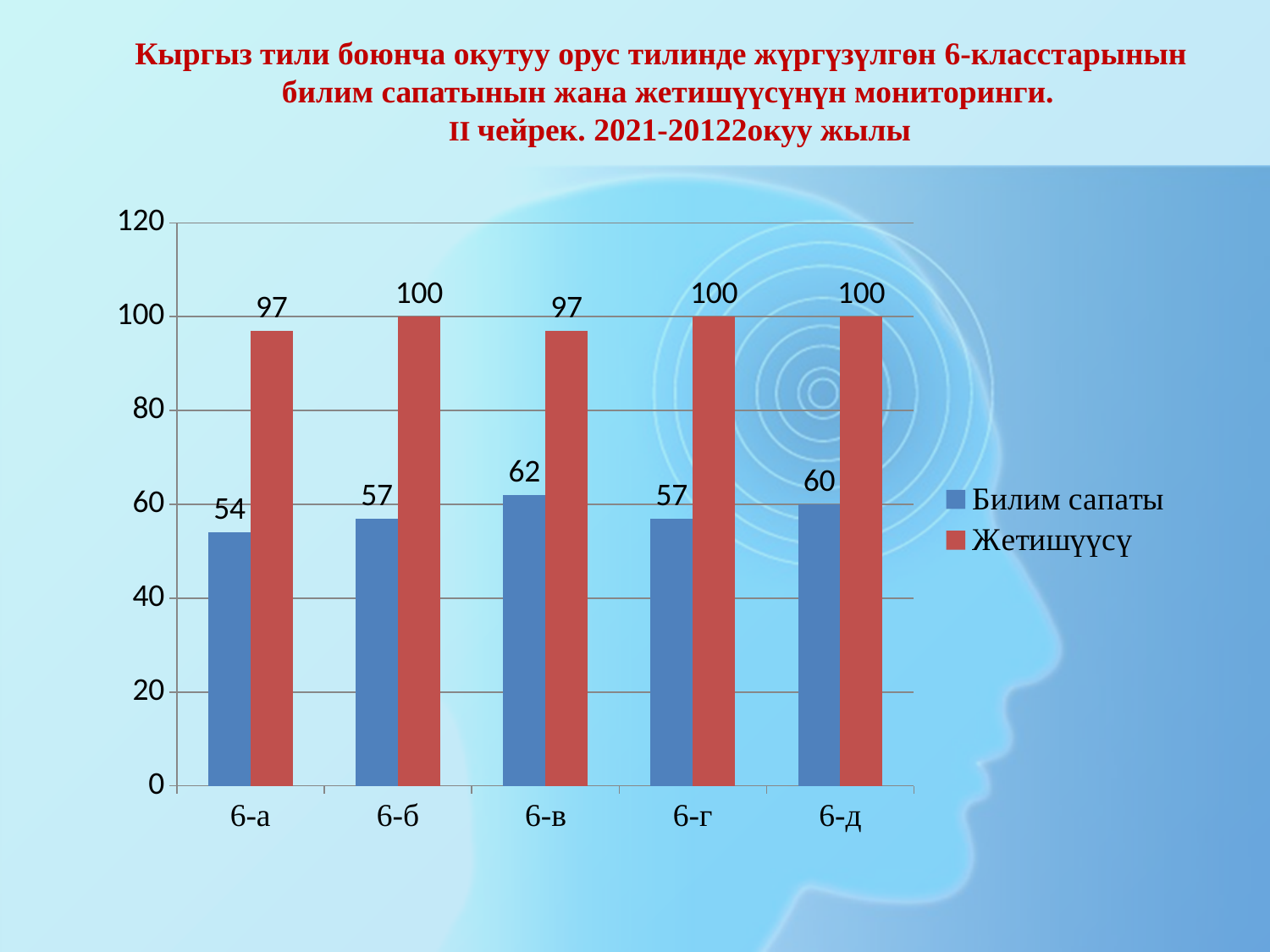
What is the value of Билим сапаты for 6-д? 60 What is the difference between Жетишүүсү and Билим сапаты for 6-б? 43 What is the value of Жетишүүсү for 6-в? 97 Which is larger, Билим сапаты for 6-д or for 6-г? 6-д How many series does the legend list? 2 How many classes are shown on the x axis? 5 What kind of chart is shown on the slide? bar chart What is the difference in Билим сапаты between 6-в and 6-а? 8 Which class has the highest Билим сапаты value? 6-в Is the Билим сапаты value for 6-в greater or less than 60? greater What is the value of Билим сапаты for 6-а? 54 Which class has the lowest Билим сапаты value? 6-а